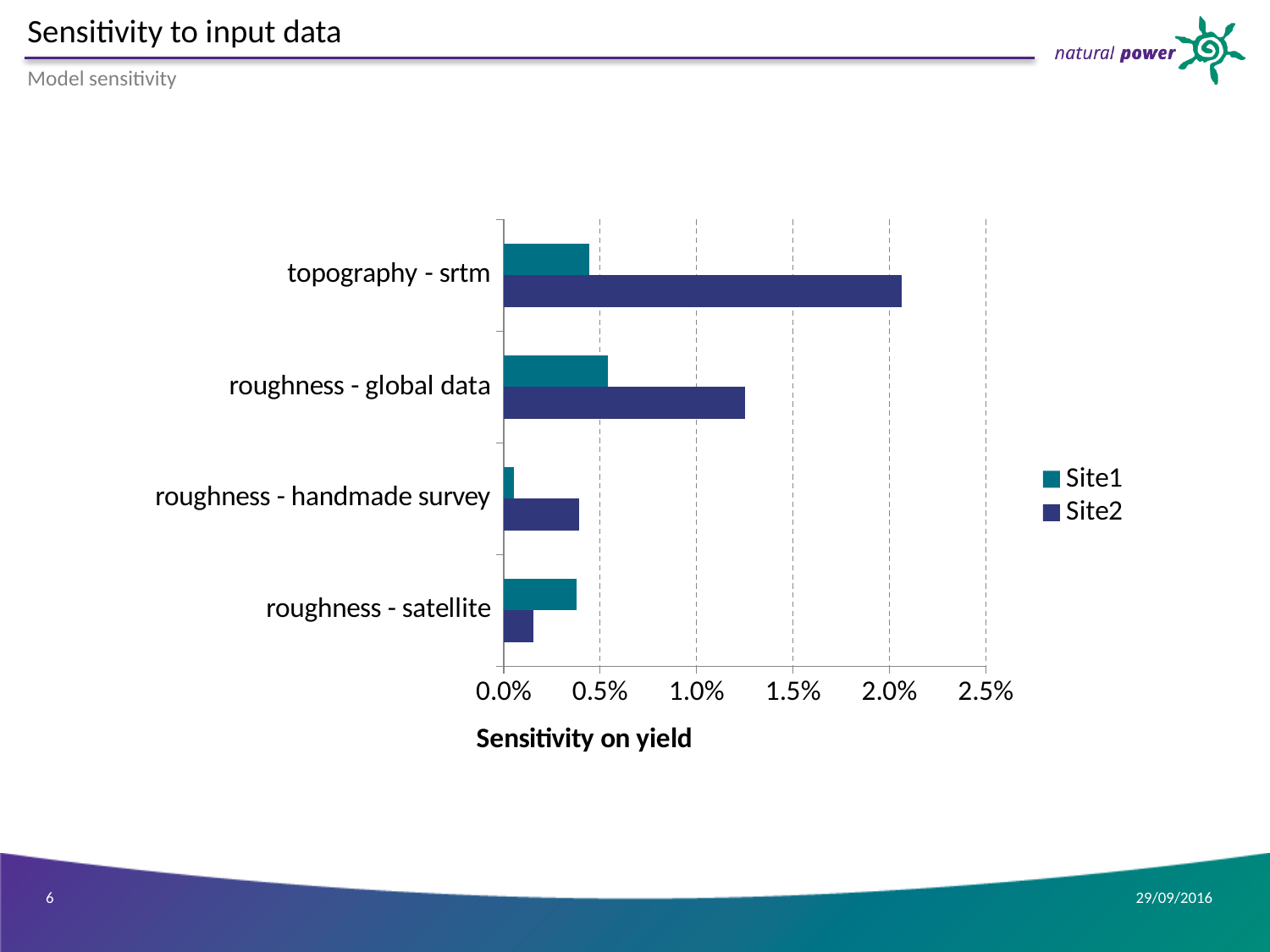
For roughness - satellite, which series has the larger value, Site1 or Site2? Site1 How many categories are shown on the chart? 4 Is the Site2 value for roughness - global data greater or less than 1.0%? greater Is the Site2 value for topography - srtm greater or less than 2.0%? greater Which category has the lowest value for Site1? roughness - handmade survey Which category has the highest value for Site2? topography - srtm What kind of chart is shown on the slide? bar chart Is the Site1 value for roughness - global data greater or less than 1.0%? less How many series does the legend list? 2 Which category has the lowest value for Site2? roughness - satellite What is the title of the horizontal axis? Sensitivity on yield For topography - srtm, which series has the larger value, Site1 or Site2? Site2